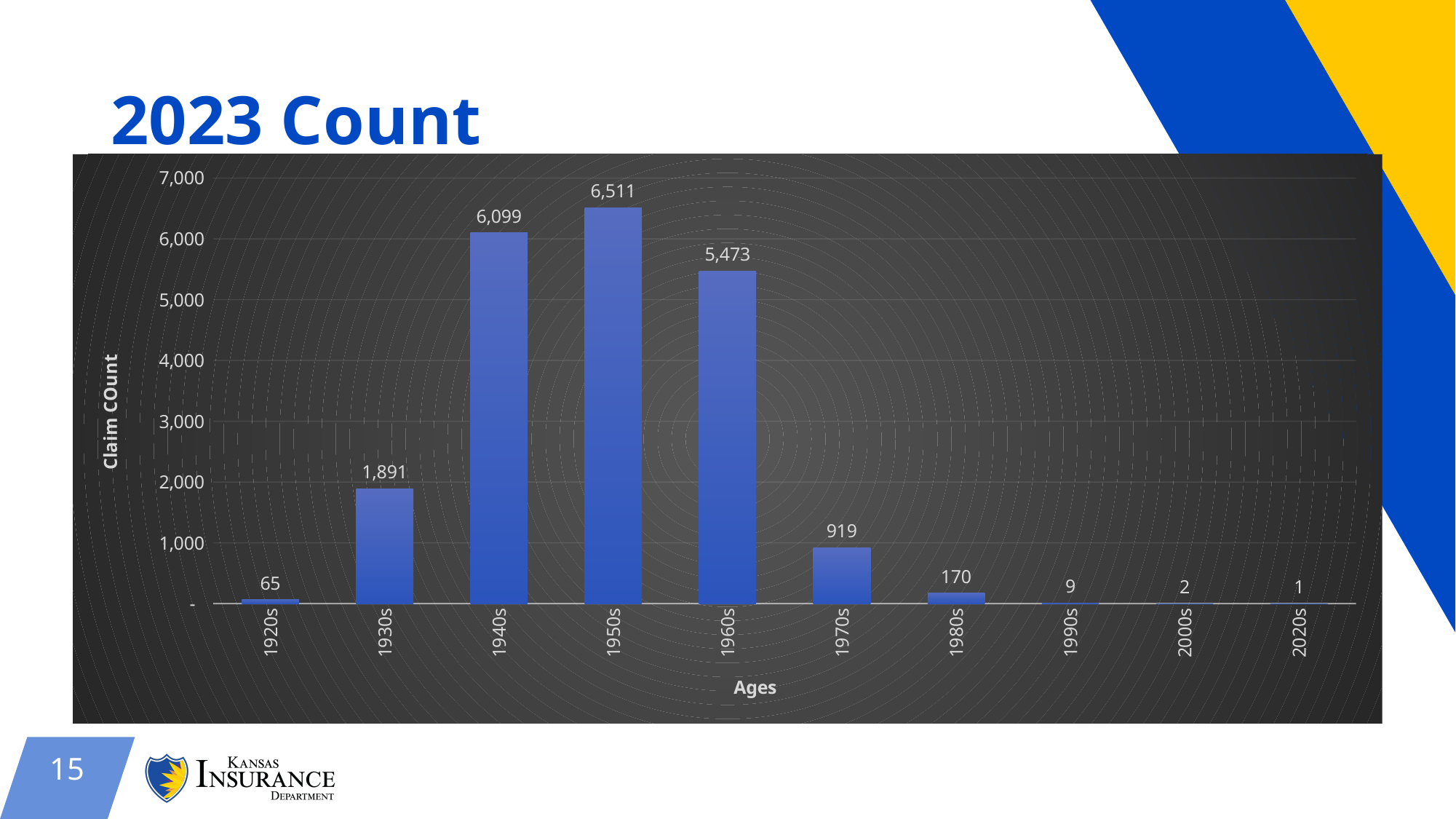
What is the claim count for the 1950s age group? 6,511 What is the claim count for the 1930s age group? 1,891 Which age group has the highest claim count? 1950s What is the difference in claim count between the 1950s and 1940s age groups? 412 What is the label of the y axis? Claim COunt Which age group has a larger claim count, the 1960s or the 1930s? 1960s What is the claim count for the 1970s age group? 919 What kind of chart is shown on the slide? Bar chart How many age groups are shown on the x axis? 10 Which age group has the lowest claim count? 2020s Is the claim count for the 1940s greater or less than 6,000? greater What is the title of the slide? 2023 Count